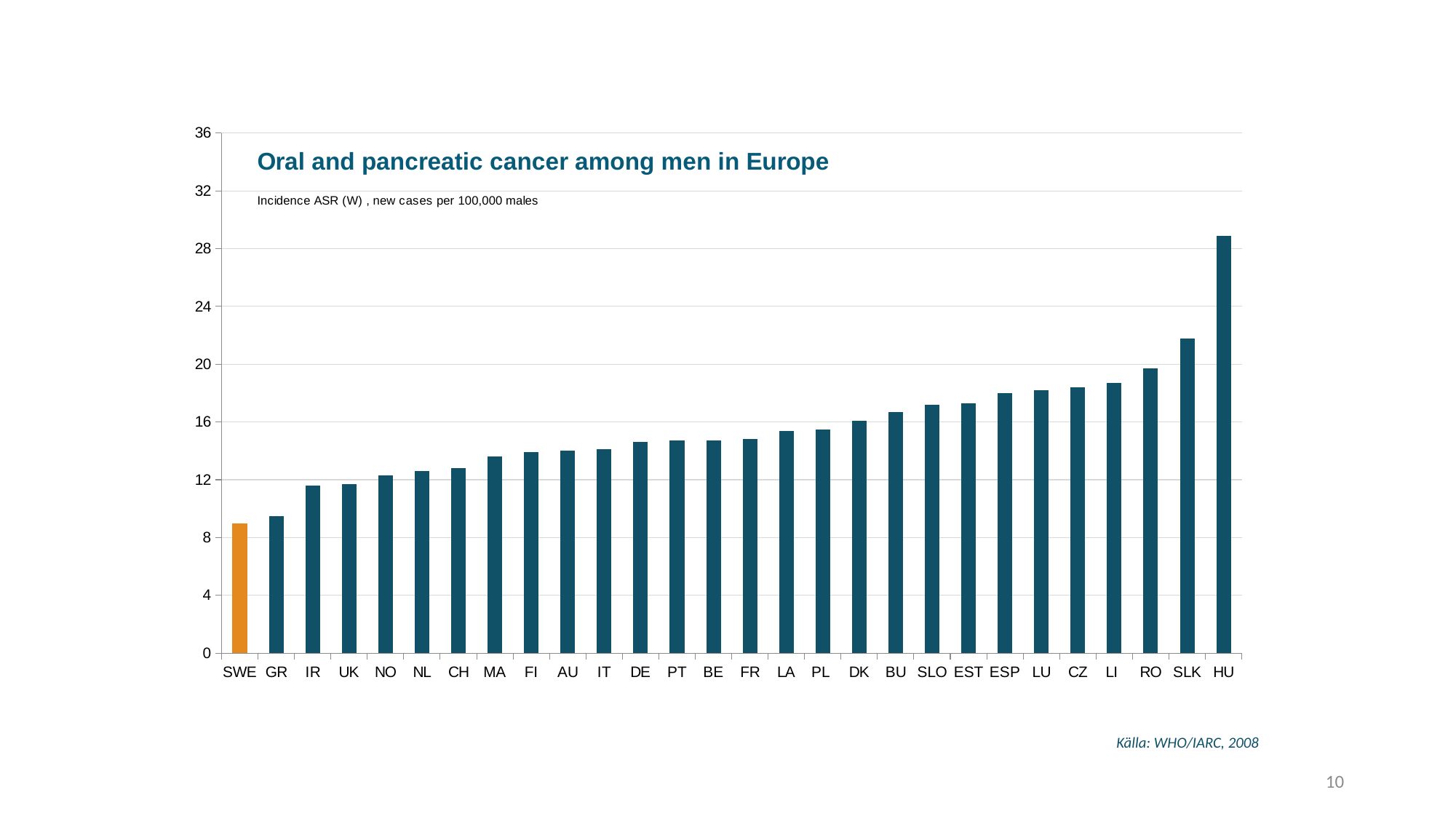
Do the values rise or fall from left to right along the x axis? rise How many countries are shown in the chart? 28 Is the value for IR greater or less than 12? less Which country has the highest incidence in the chart? HU Is the value for ESP greater or less than 16? greater Which country's bar is shown in orange rather than dark blue? SWE Is the value for SLK greater or less than 20? greater What kind of chart is shown on the slide? bar chart Which country has the lowest incidence in the chart? SWE Which has the larger value, FR or LI? LI